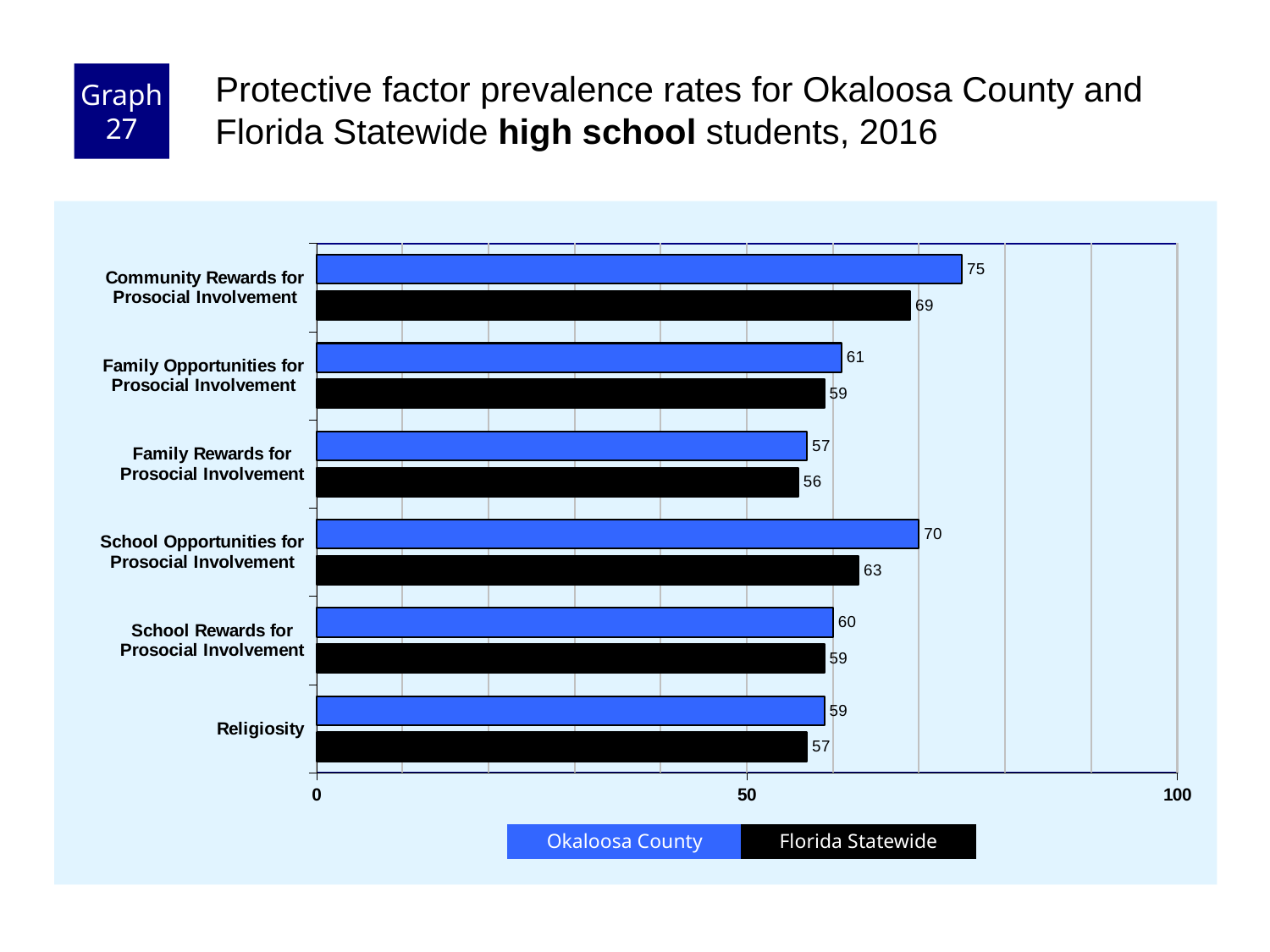
Which category has the highest Okaloosa County value? Community Rewards for Prosocial Involvement Is the Okaloosa County value for School Opportunities for Prosocial Involvement greater or less than 50? greater What kind of chart is shown on the slide? bar chart What is the Okaloosa County value for Community Rewards for Prosocial Involvement? 75 How many series does the legend list? 2 Which category has the lowest Florida Statewide value? Family Rewards for Prosocial Involvement How many categories are shown on the chart? 6 What is the Florida Statewide value for Religiosity? 57 What is the difference between the Okaloosa County and Florida Statewide values for Community Rewards for Prosocial Involvement? 6 Which is larger for Family Opportunities for Prosocial Involvement: the Okaloosa County value or the Florida Statewide value? Okaloosa County What is the Florida Statewide value for School Opportunities for Prosocial Involvement? 63 What is the difference between the Okaloosa County and Florida Statewide values for School Opportunities for Prosocial Involvement? 7